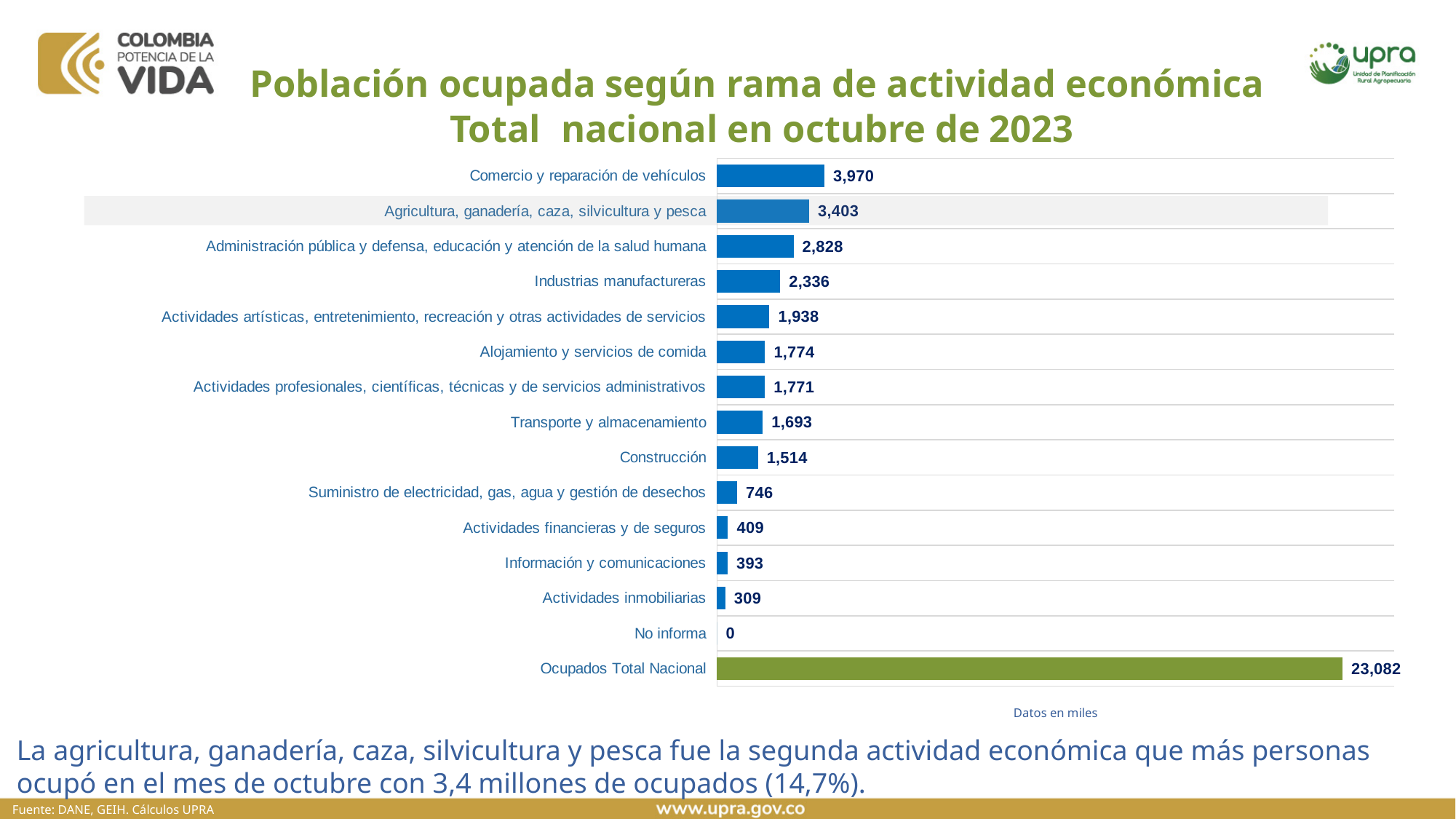
Which is larger, the value for Transporte y almacenamiento or the value for Construcción? Transporte y almacenamiento Which category has the lowest value in the chart? No informa What is the value for Agricultura, ganadería, caza, silvicultura y pesca? 3,403 What type of chart is shown on the slide? Bar chart What is the difference between the values for Administración pública y defensa, educación y atención de la salud humana and Industrias manufactureras? 492 Excluding the Ocupados Total Nacional bar, which economic activity has the highest value? Comercio y reparación de vehículos What is the value for Ocupados Total Nacional? 23,082 What is the difference between the values for Comercio y reparación de vehículos and Agricultura, ganadería, caza, silvicultura y pesca? 567 What is the value for Comercio y reparación de vehículos? 3,970 According to the note below the chart, in what units are the data expressed? Datos en miles How many categories (bars) are shown in the chart, including Ocupados Total Nacional? 15 What is the value for Suministro de electricidad, gas, agua y gestión de desechos? 746